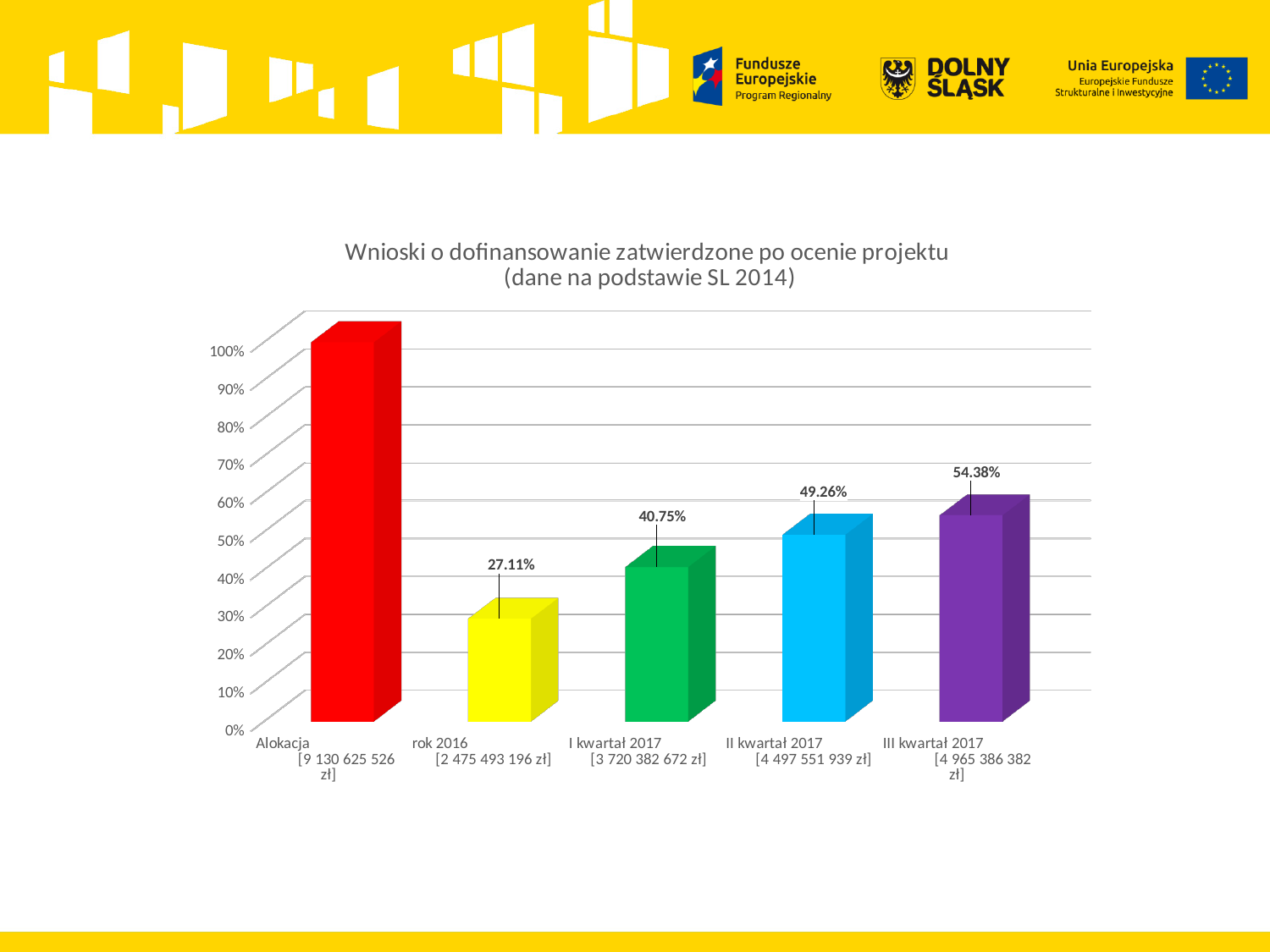
Which category has the lowest value? rok 2016 What is the value for I kwartał 2017? 40.75% Do the values rise or fall from rok 2016 to III kwartał 2017? rise What is the difference between the values for III kwartał 2017 and II kwartał 2017? 5.12 percentage points Is the value for Alokacja greater or less than 90%? greater Which is larger, the value for II kwartał 2017 or the value for I kwartał 2017? II kwartał 2017 Which category has the highest bar? Alokacja What kind of chart is shown on the slide? bar chart What is the value for III kwartał 2017? 54.38% What is the value for rok 2016? 27.11% How many categories are shown on the x axis? 5 What is the value for II kwartał 2017? 49.26%